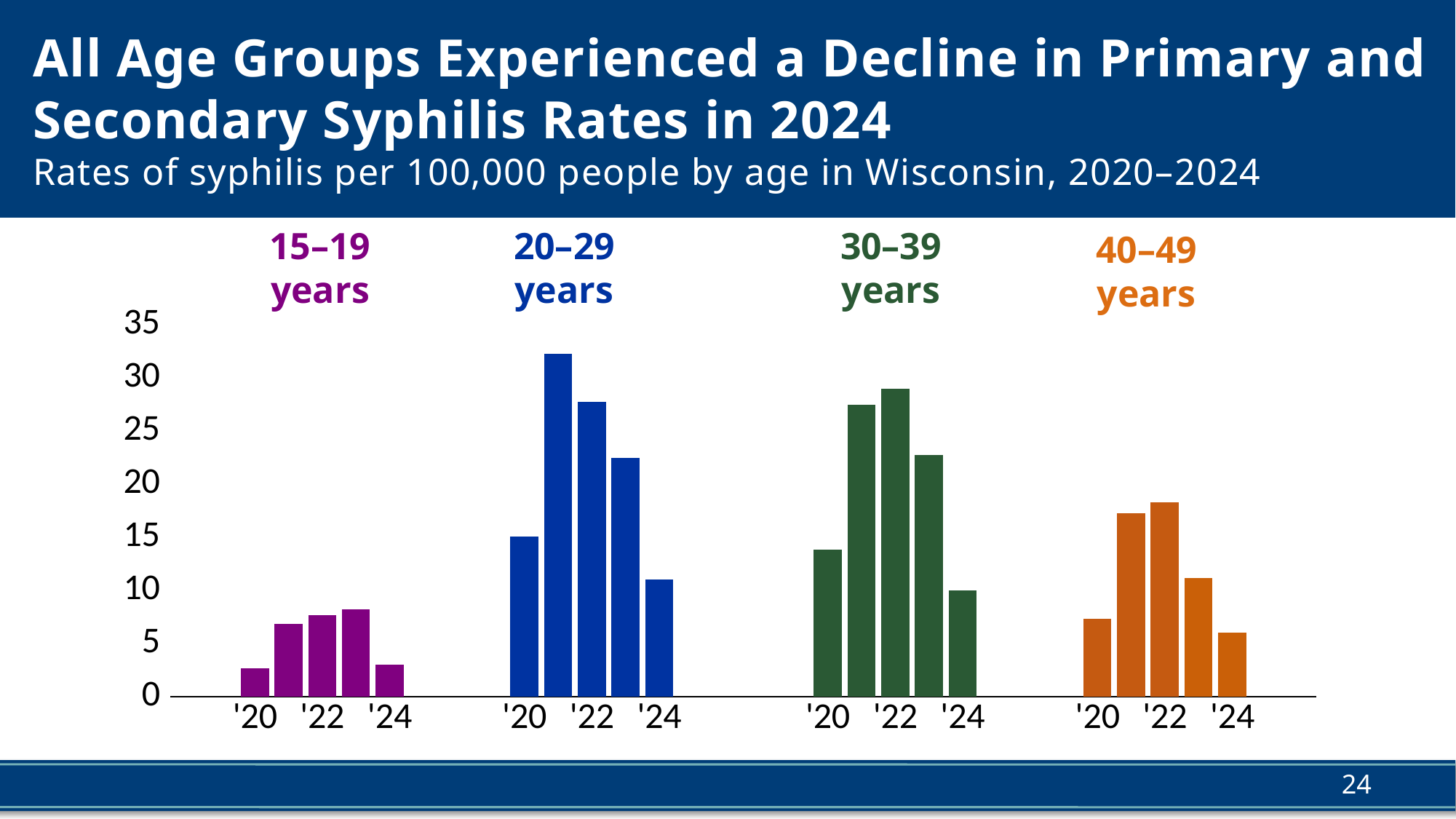
Is the value for 20–29 years in 2021 greater or less than 30? greater Within the 20–29 years group, which year has the lowest bar? 2024 Within the 15–19 years group, which year has the lowest bar? 2020 Which is larger: the 2021 value for 20–29 years or the 2022 value for 30–39 years? 2021 value for 20–29 years Is the value for 15–19 years in 2024 greater or less than 5? less Do the values for the 20–29 years group rise or fall from 2021 to 2024? fall What kind of chart is shown on the slide? bar chart Is the value for 40–49 years in 2022 greater or less than 15? greater How many age groups are shown in the chart? 4 How many bars (years) are plotted for each age group? 5 Which age group and year has the highest bar in the chart? 20–29 years, 2021 Within the 30–39 years group, which year has the highest bar? 2022